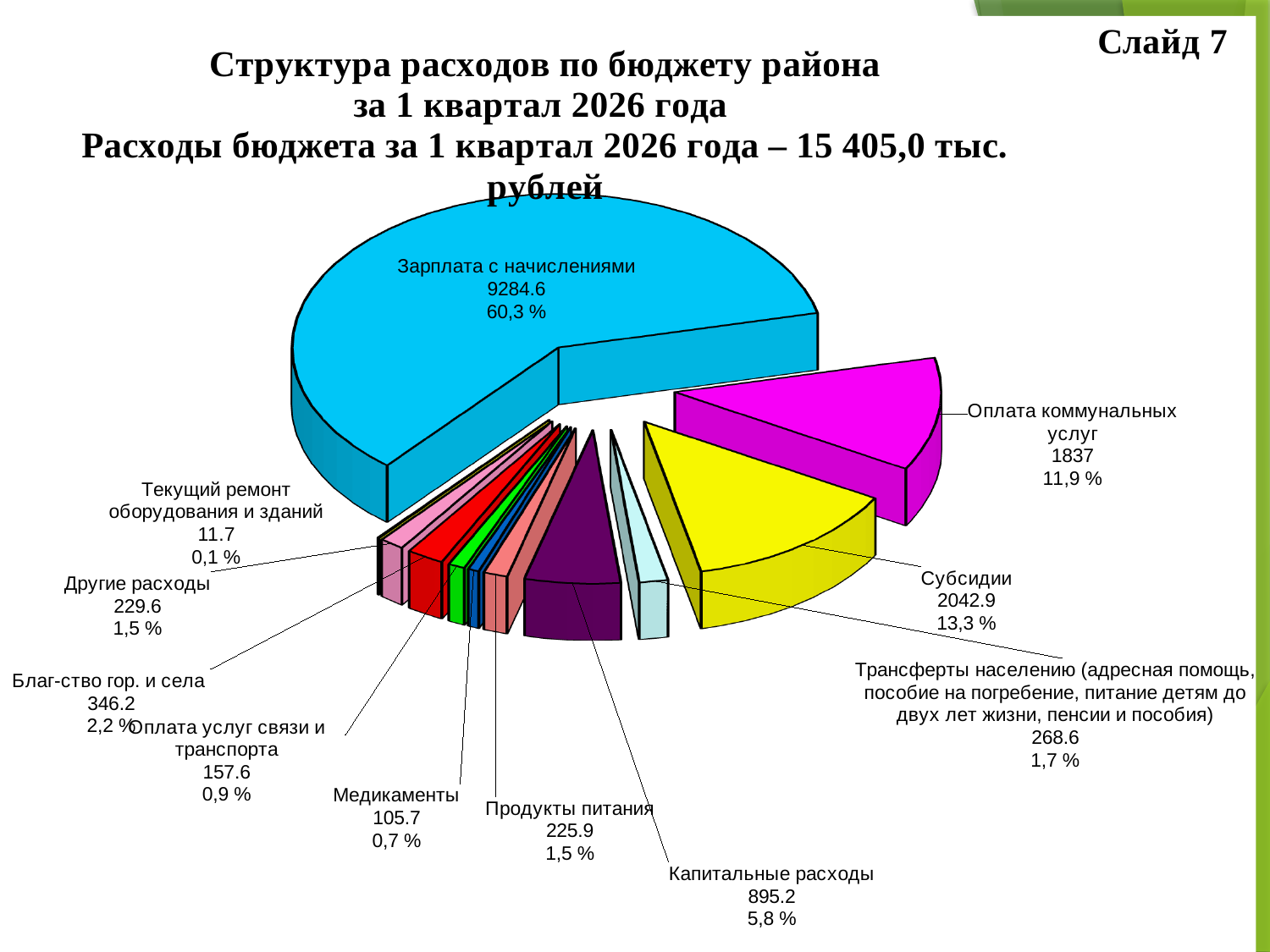
What is the difference between the values for Субсидии and Оплата коммунальных услуг? 205.9 What is the value shown for Оплата коммунальных услуг? 1837 How many categories are shown in the pie chart? 11 Which category has the largest slice of the pie? Зарплата с начислениями Which is larger, Субсидии or Оплата коммунальных услуг? Субсидии What percentage is shown for Капитальные расходы? 5,8 % What kind of chart is shown on the slide? Pie chart Which category has the smallest slice of the pie? Текущий ремонт оборудования и зданий What share of the pie does Субсидии account for? 13,3 % What total budget expenditure for the 1st quarter of 2026 is stated in the chart title? 15 405,0 тыс. рублей What is the value shown for Зарплата с начислениями? 9284.6 What is the value shown for Медикаменты? 105.7